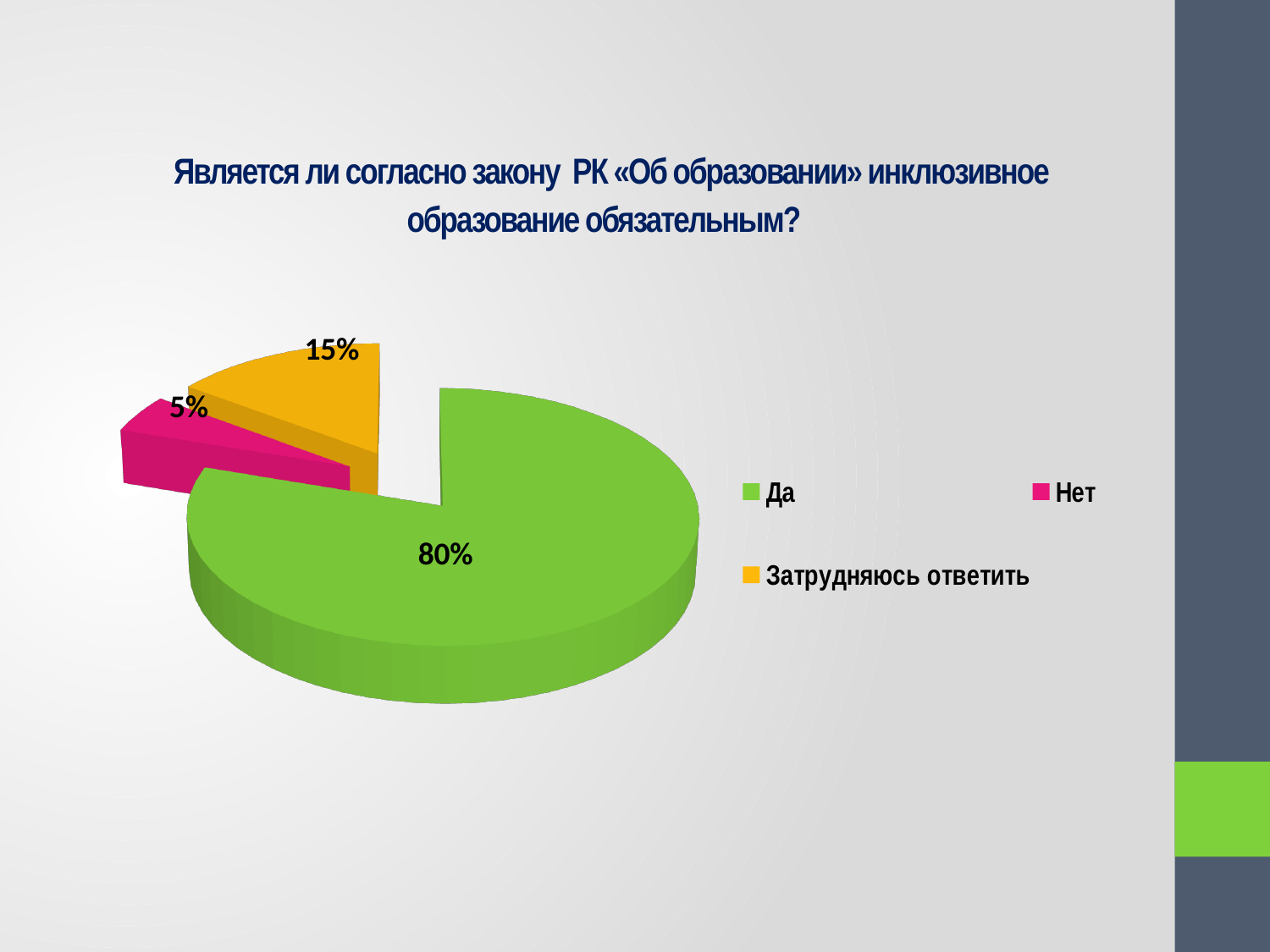
What colour is the slice for "Да"? Green What is the difference between the shares for "Затрудняюсь ответить" and "Нет"? 10% Which category has the largest slice of the pie? Да How many categories does the pie chart have? 3 What share of the pie does "Затрудняюсь ответить" represent? 15% What type of chart is shown on the slide? Pie chart Which category has the smallest slice of the pie? Нет What is the difference between the shares for "Да" and "Затрудняюсь ответить"? 65% What is the title of the chart? Является ли согласно закону РК «Об образовании» инклюзивное образование обязательным? What share of the pie does "Да" represent? 80% Which is larger, the share for "Нет" or the share for "Затрудняюсь ответить"? Затрудняюсь ответить What share of the pie does "Нет" represent? 5%